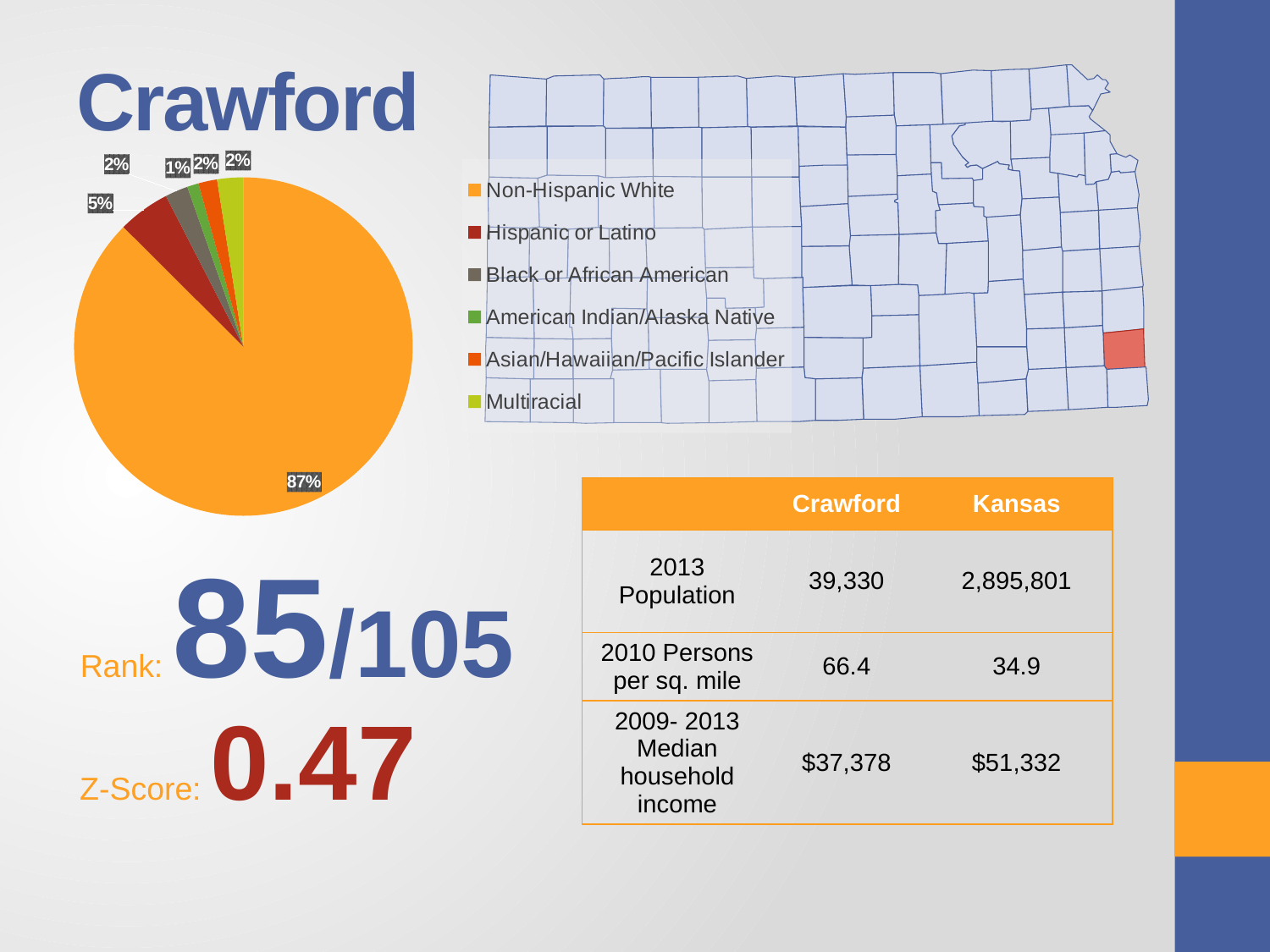
What percentage does the pie chart show for American Indian/Alaska Native? 1% What percentage does the pie chart show for Hispanic or Latino? 5% How many categories does the pie chart show? 6 What colour is the Non-Hispanic White slice in the pie chart? Orange What is the difference in percentage points between the Non-Hispanic White slice and the Hispanic or Latino slice? 82 What share of the pie chart is Non-Hispanic White? 87% Which is larger in the pie chart: Hispanic or Latino or Multiracial? Hispanic or Latino What kind of chart is shown on the slide? Pie chart What percentage does the pie chart show for Black or African American? 2% Which category has the smallest slice in the pie chart? American Indian/Alaska Native Which category has the largest slice in the pie chart? Non-Hispanic White Which legend entry is listed last in the pie chart's legend? Multiracial